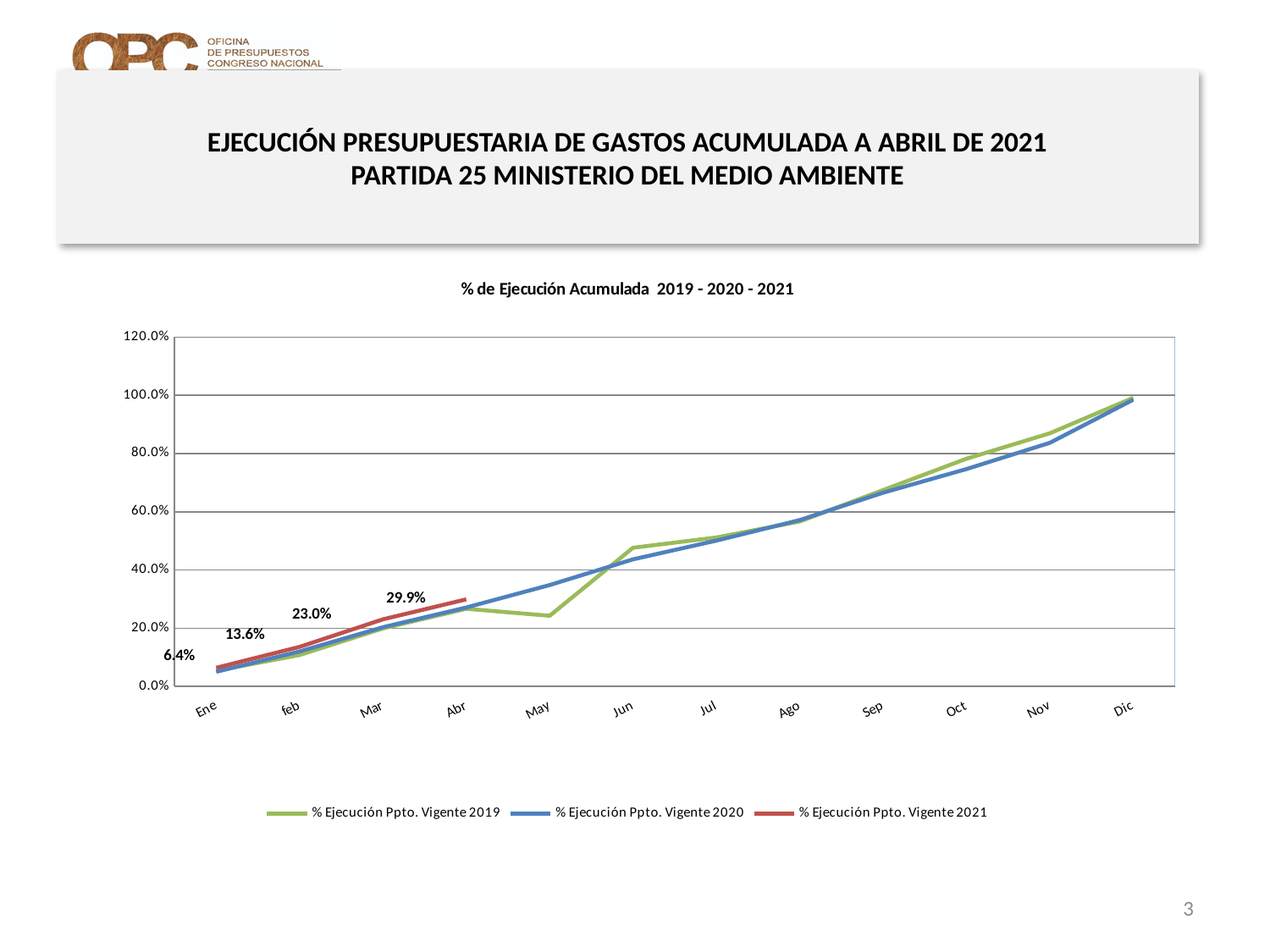
What is the value of % Ejecución Ppto. Vigente 2021 for feb? 13.6% How many series does the legend list? 3 What kind of chart is shown on the slide? line chart What is the difference between the % Ejecución Ppto. Vigente 2021 values for Abr and Mar? 6.9% Is the value of % Ejecución Ppto. Vigente 2019 for May greater or less than 40.0%? less What is the value of % Ejecución Ppto. Vigente 2021 for Mar? 23.0% How many months are shown on the x axis? 12 What is the title of the chart? % de Ejecución Acumulada 2019 - 2020 - 2021 Does the % Ejecución Ppto. Vigente 2021 line rise or fall from Ene to Abr? rise What is the value of % Ejecución Ppto. Vigente 2021 for Abr? 29.9% What is the value of % Ejecución Ppto. Vigente 2021 for Ene? 6.4% Is the value of % Ejecución Ppto. Vigente 2020 for Dic greater or less than 80.0%? greater